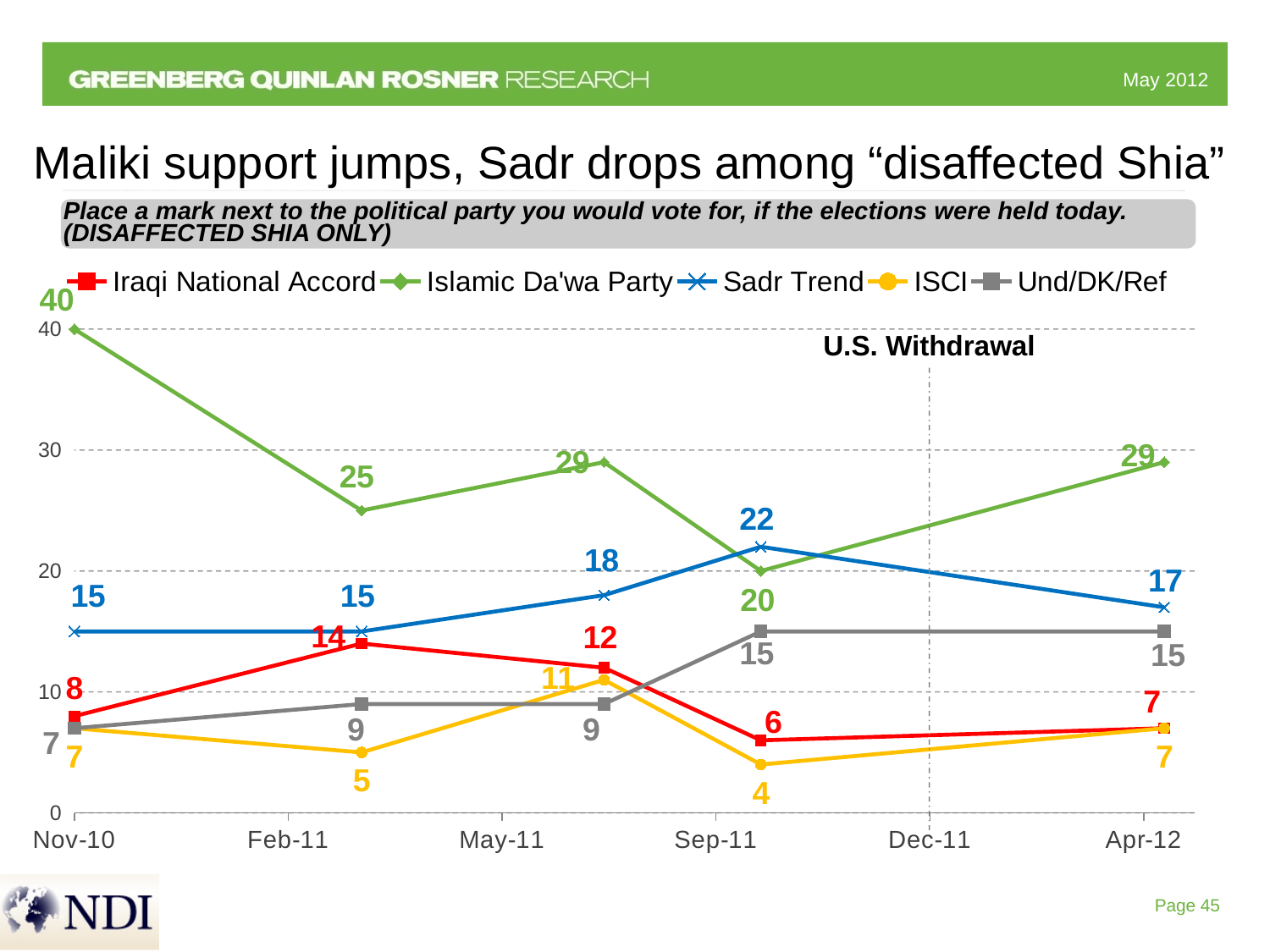
What is the value for Sadr Trend at Apr-12? 17 What is the difference between the Islamic Da'wa Party's value at Nov-10 and its value at Apr-12? 11 Which series has the highest value at Nov-10? Islamic Da'wa Party What is the highest value reached by the Sadr Trend series? 22 What kind of chart is shown on the slide? line chart Does the Und/DK/Ref series rise or fall from Nov-10 to Apr-12? rise How many series does the legend list? 5 What event is labelled by the vertical dashed line on the chart? U.S. Withdrawal How many data points does each series have? 5 What is the value for ISCI at Nov-10? 7 What is the value for the Islamic Da'wa Party at Nov-10? 40 At Apr-12, which is larger: Sadr Trend or Und/DK/Ref? Sadr Trend